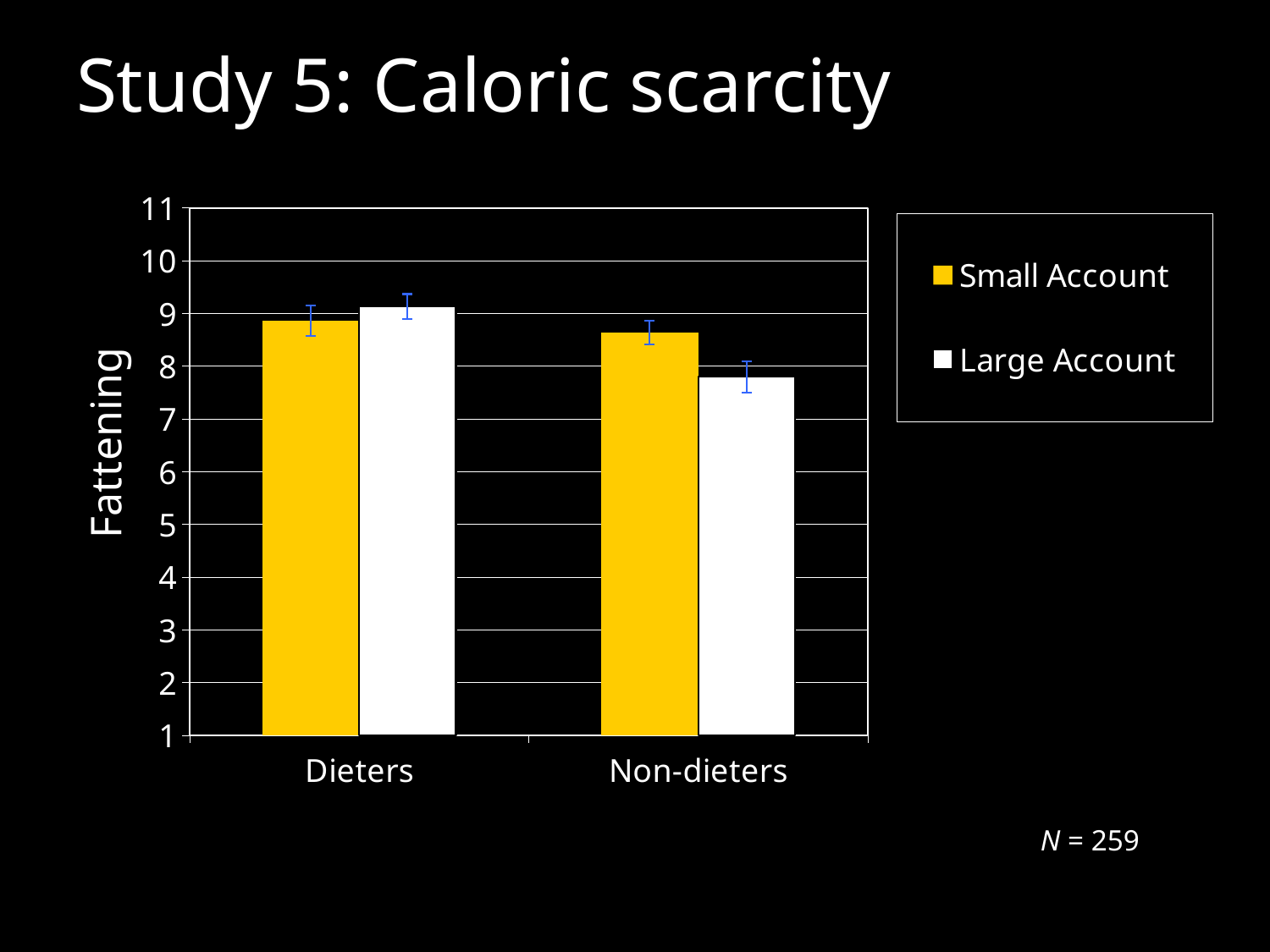
Which category has the lower Large Account value, Dieters or Non-dieters? Non-dieters What are the two series listed in the chart's legend? Small Account and Large Account What is the label on the chart's y axis? Fattening For Non-dieters, which is larger: the Small Account value or the Large Account value? Small Account Is the Large Account value for Dieters greater or less than 8? greater What kind of chart is shown on the slide? Bar chart Which bar in the chart has the lowest value? Large Account for Non-dieters How many categories are shown on the x axis of the chart? 2 Is the Small Account value for Dieters greater or less than 8? greater How many series does the chart's legend list? 2 Is the Small Account value for Non-dieters greater or less than 9? less